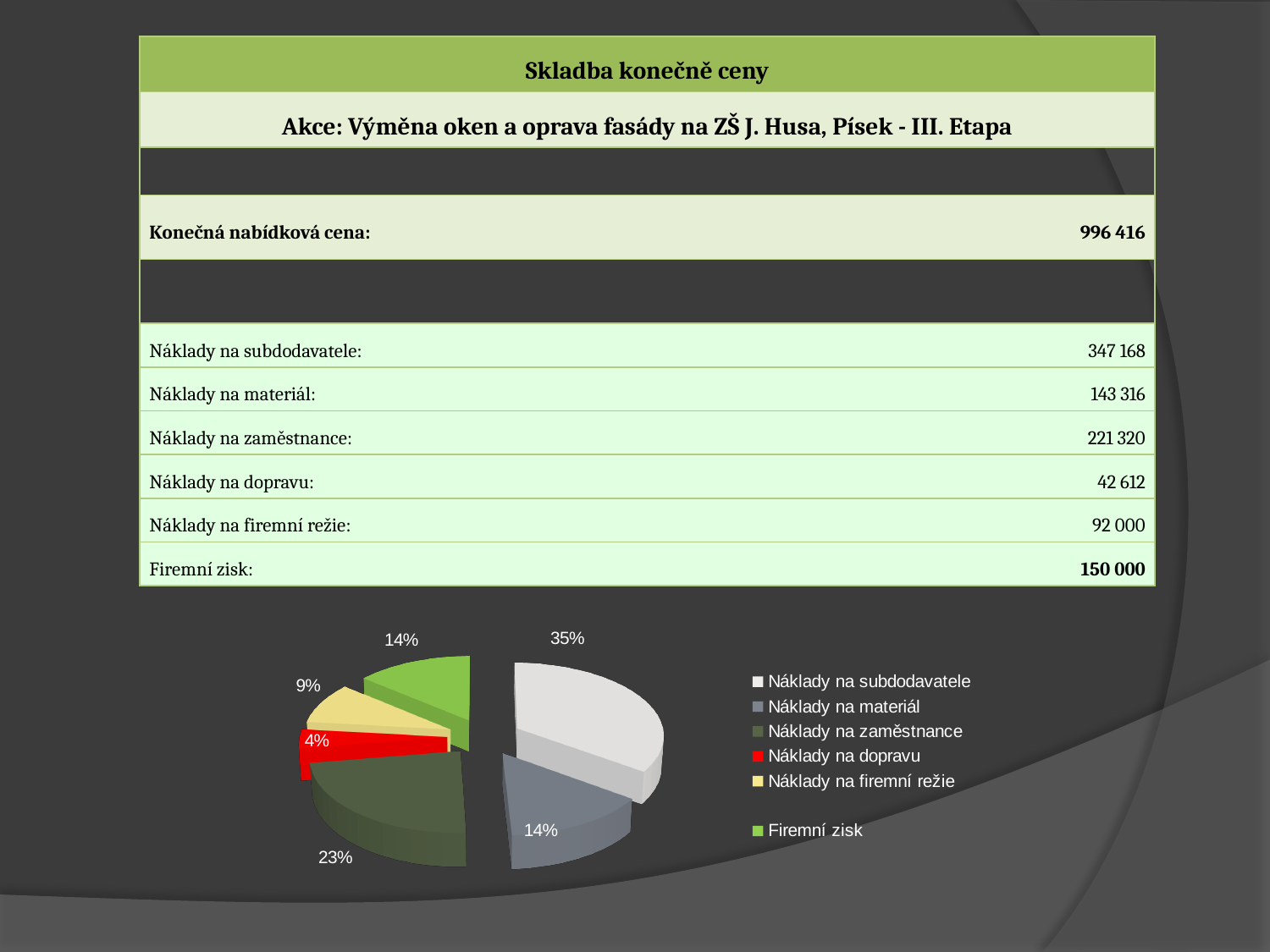
What share of the pie does Náklady na subdodavatele represent? 35% What share of the pie does Firemní zisk represent? 14% What colour is the Náklady na dopravu slice in the pie chart? red Which slice is larger: Náklady na zaměstnance or Náklady na materiál? Náklady na zaměstnance What share of the pie does Náklady na firemní režie represent? 9% Which category has the largest slice of the pie? Náklady na subdodavatele What kind of chart is shown at the bottom of the slide? pie chart What is the difference in percentage points between the Náklady na subdodavatele slice and the Náklady na zaměstnance slice? 12% Which category has the smallest slice of the pie? Náklady na dopravu How many slices does the pie chart have? 6